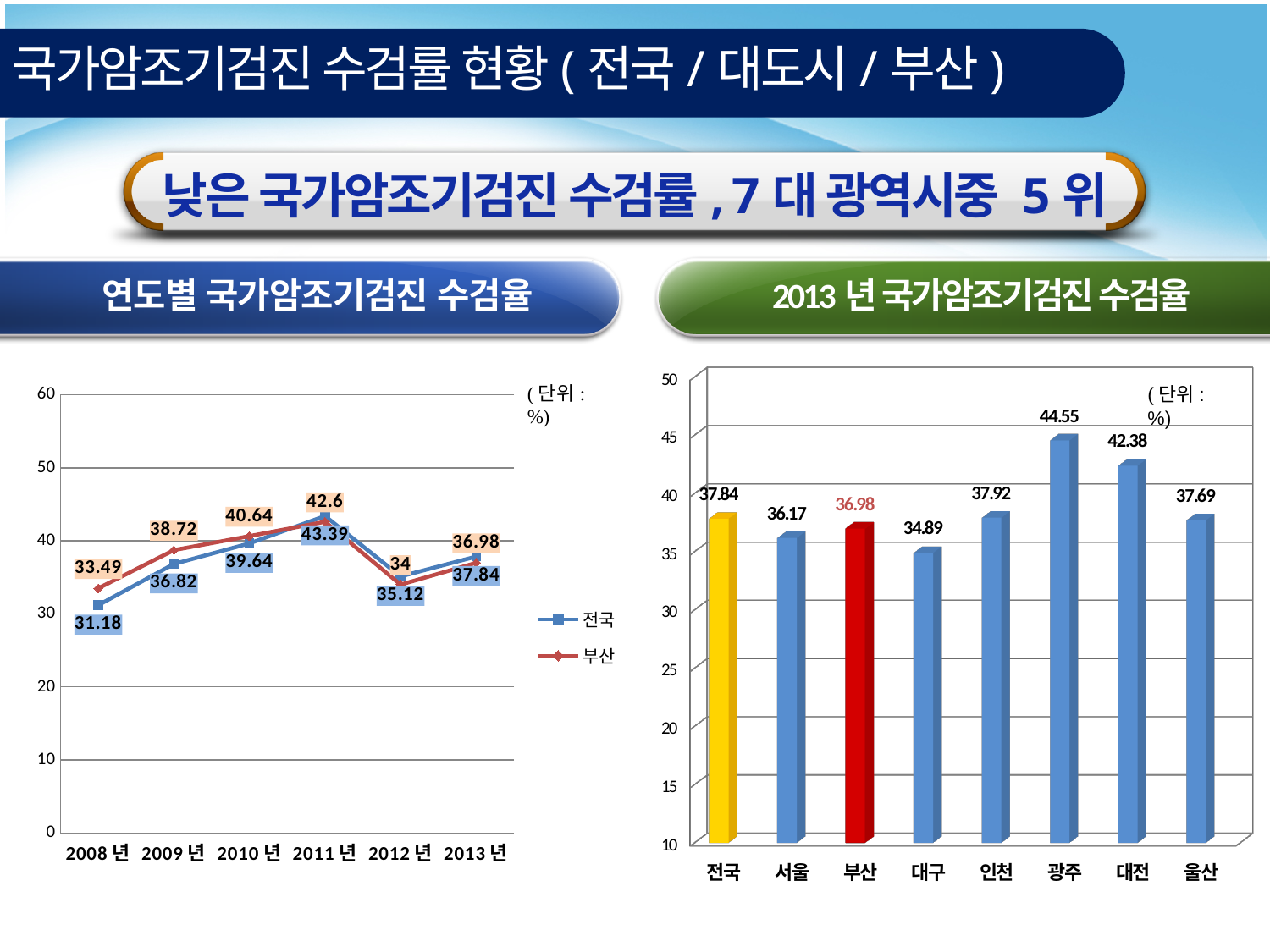
In the right chart (2013년 국가암조기검진 수검율), which is larger, 대전 or 울산? 대전 In the right chart (2013년 국가암조기검진 수검율), what is the value for 광주? 44.55 In the left chart (연도별 국가암조기검진 수검율), what is the value for 부산 in 2011년? 42.6 In the right chart (2013년 국가암조기검진 수검율), what colour is the 부산 bar? Red In the right chart (2013년 국가암조기검진 수검율), which city has the lowest value? 대구 In the left chart (연도별 국가암조기검진 수검율), how many series does the legend list? 2 In the left chart (연도별 국가암조기검진 수검율), what kind of chart is it? Line chart In the right chart (2013년 국가암조기검진 수검율), what is the difference between 광주 and 부산? 7.57 In the left chart (연도별 국가암조기검진 수검율), what is the value for 전국 in 2008년? 31.18 In the right chart (2013년 국가암조기검진 수검율), how many categories are shown on the x axis? 8 In the left chart (연도별 국가암조기검진 수검율), what is the difference between the 부산 and 전국 values in 2009년? 1.9 In the left chart (연도별 국가암조기검진 수검율), in which year is the 전국 value highest? 2011년